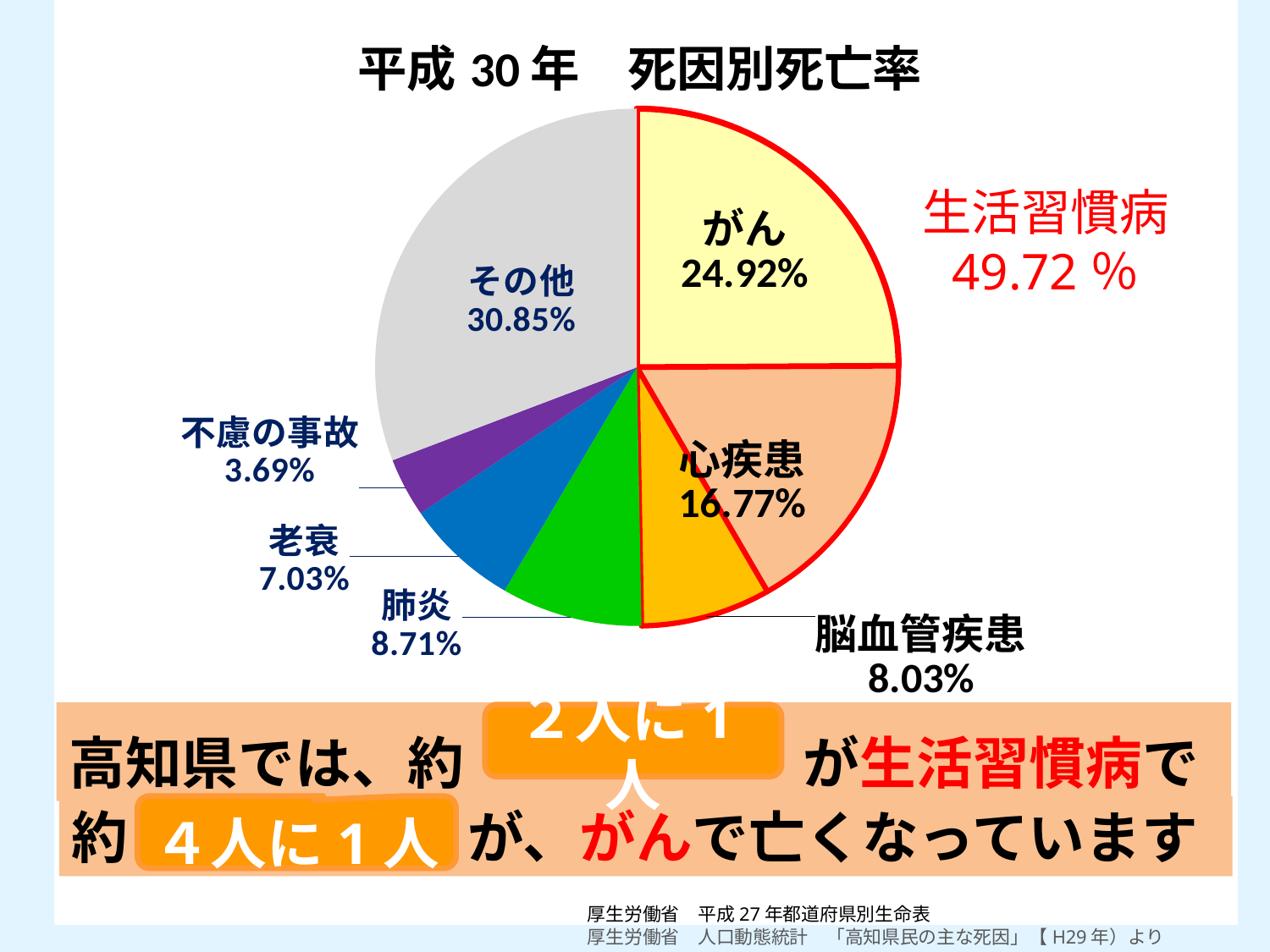
Which is larger, the share for 肺炎 or the share for 脳血管疾患? 肺炎 What is the title of the chart? 平成30年 死因別死亡率 What percentage of the pie is 老衰? 7.03% What percentage of the pie is 脳血管疾患? 8.03% Which slice of the pie is the largest? その他 What is the difference in percentage points between がん and 心疾患? 8.15 What is the combined share of がん, 心疾患 and 脳血管疾患, labelled 生活習慣病 on the slide? 49.72% What percentage of the pie is がん? 24.92% How many slices does the pie chart have? 7 What kind of chart is shown on the slide? pie chart What percentage of the pie is 心疾患? 16.77% Which slice of the pie is the smallest? 不慮の事故